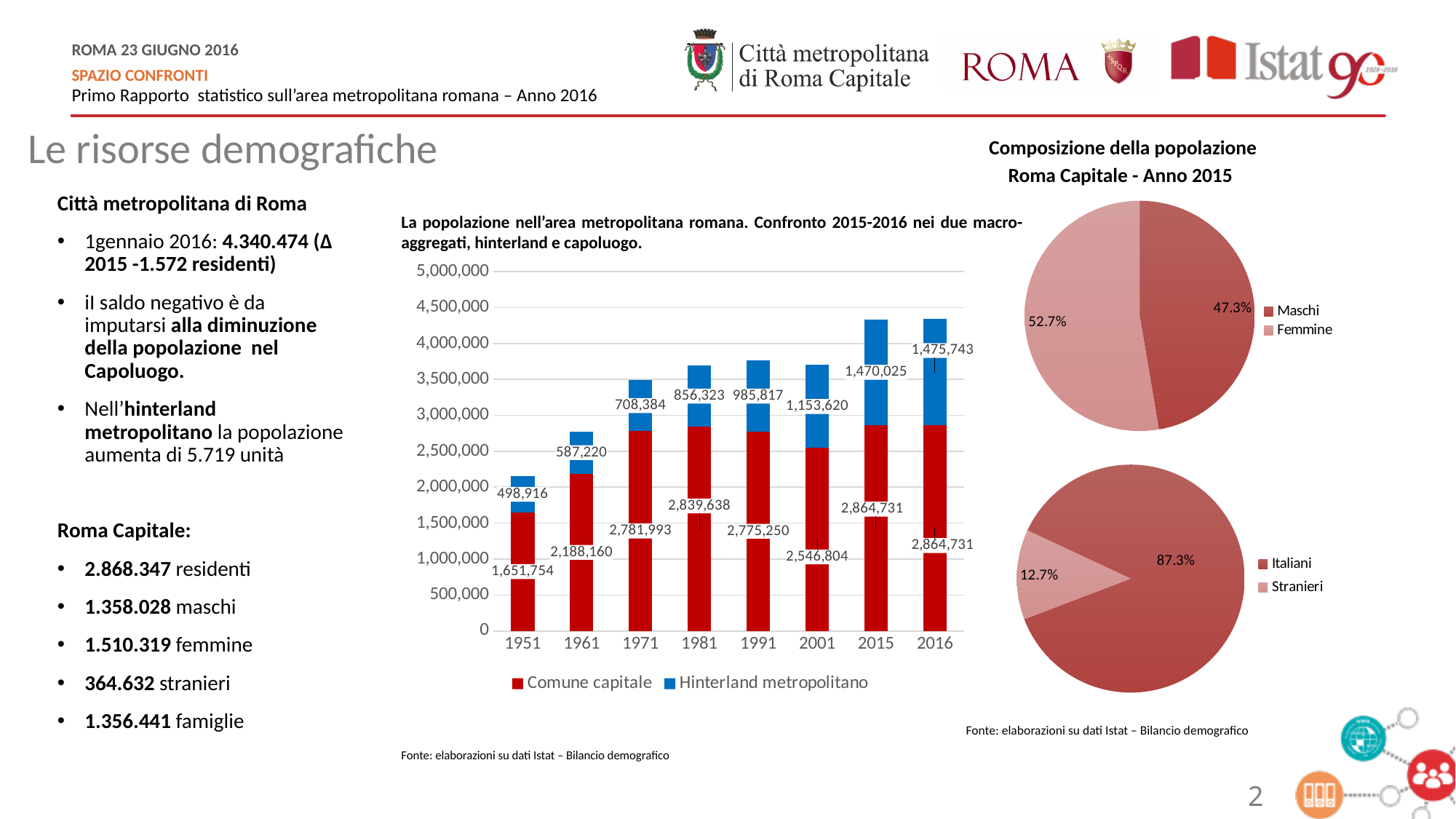
In the bar chart 'La popolazione nell'area metropolitana romana', which year has the highest value for Hinterland metropolitano? 2016 How many years are shown on the x axis of the bar chart 'La popolazione nell'area metropolitana romana'? 8 How many series does the legend of the bar chart 'La popolazione nell'area metropolitana romana' list? 2 In the bar chart 'La popolazione nell'area metropolitana romana', what is the value for Hinterland metropolitano in 1951? 498,916 What kind of chart is 'La popolazione nell'area metropolitana romana'? Stacked bar chart In the upper pie chart under 'Composizione della popolazione Roma Capitale - Anno 2015', what share is Femmine? 52.7% In the bar chart 'La popolazione nell'area metropolitana romana', which year has the lowest value for Comune capitale? 1951 In the bar chart 'La popolazione nell'area metropolitana romana', what is the difference between the Hinterland metropolitano values for 2016 and 2015? 5,718 In the bar chart 'La popolazione nell'area metropolitana romana', what is the value for Comune capitale in 2001? 2,546,804 In the lower pie chart under 'Composizione della popolazione Roma Capitale - Anno 2015', what share is Stranieri? 12.7% In the bar chart 'La popolazione nell'area metropolitana romana', is the Comune capitale value larger in 1981 or in 1991? 1981 In the bar chart 'La popolazione nell'area metropolitana romana', what is the total of the stacked bar for 1951? 2,150,670